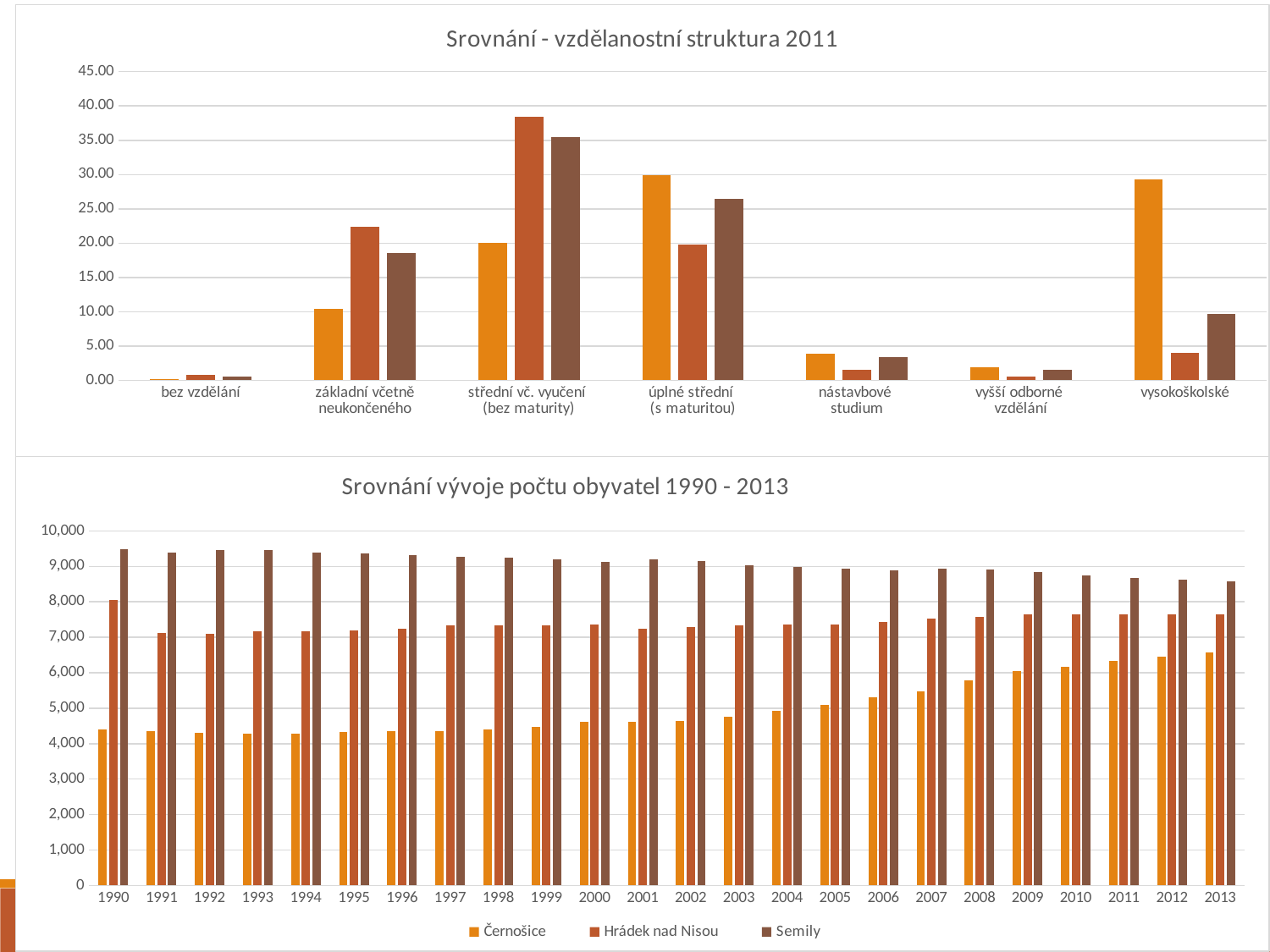
In the chart 'Srovnání vývoje počtu obyvatel 1990 - 2013', which series has the lowest value in 2013? Černošice In the chart 'Srovnání vývoje počtu obyvatel 1990 - 2013', is the value for Semily in 1990 greater or less than 9,000? greater In the chart 'Srovnání vývoje počtu obyvatel 1990 - 2013', does the value for Semily rise or fall from 1990 to 2013? fall In the chart 'Srovnání vývoje počtu obyvatel 1990 - 2013', which series has the highest value in 1990? Semily In the chart 'Srovnání - vzdělanostní struktura 2011', which category contains the tallest bar? střední vč. vyučení (bez maturity) What kind of chart is 'Srovnání - vzdělanostní struktura 2011'? bar chart In the chart 'Srovnání vývoje počtu obyvatel 1990 - 2013', is the value for Hrádek nad Nisou in 2013 greater or less than 7,000? greater In the chart 'Srovnání vývoje počtu obyvatel 1990 - 2013', is the value for Černošice in 2013 greater or less than 6,000? greater In the chart 'Srovnání vývoje počtu obyvatel 1990 - 2013', how many series does the legend list? 3 In the chart 'Srovnání vývoje počtu obyvatel 1990 - 2013', how many years are shown on the x axis? 24 In the chart 'Srovnání - vzdělanostní struktura 2011', how many categories are shown on the x axis? 7 In the chart 'Srovnání vývoje počtu obyvatel 1990 - 2013', does the value for Černošice rise or fall from 1990 to 2013? rise